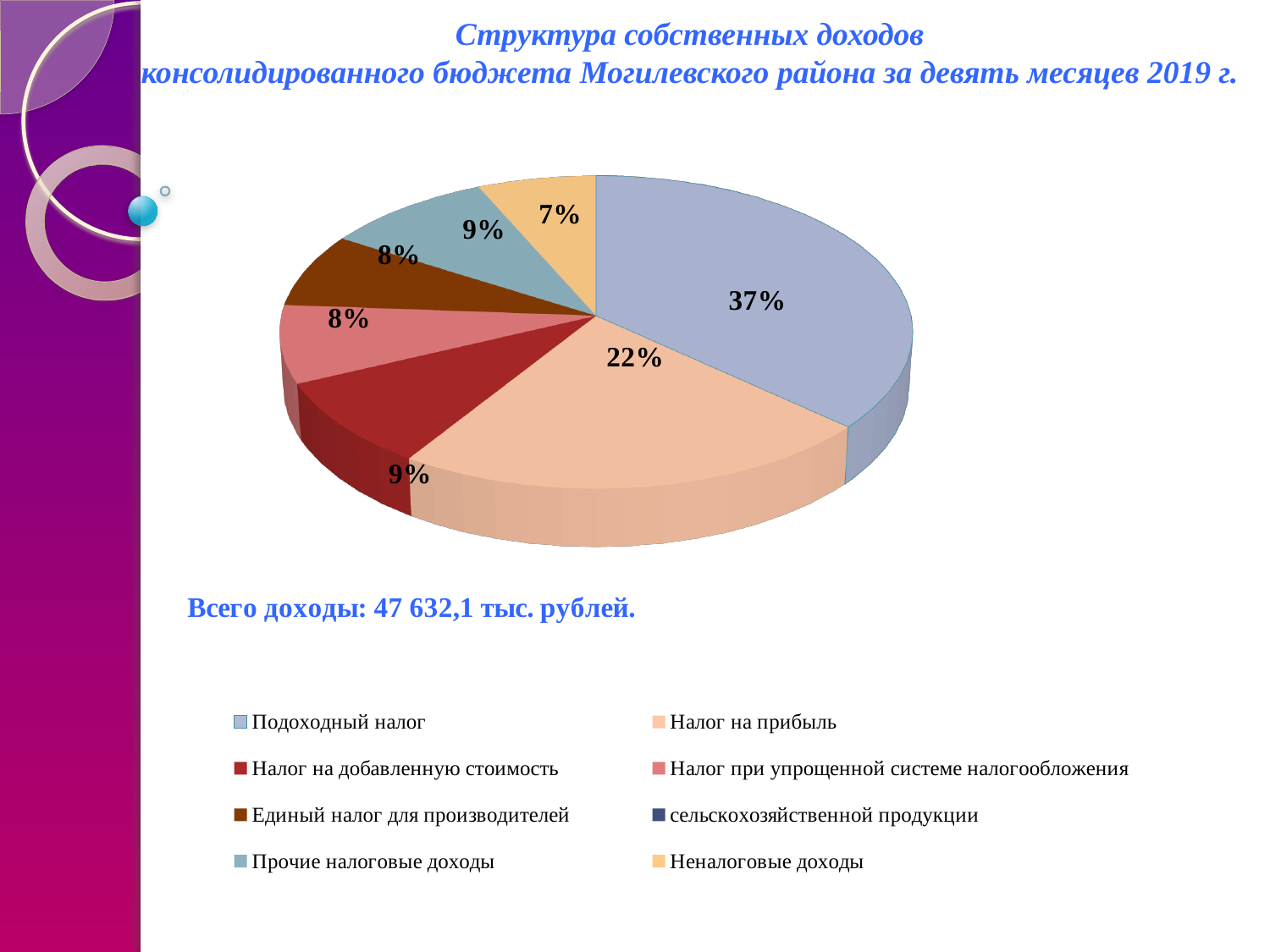
What share of the pie does Неналоговые доходы have? 7% Which is larger, the slice for Налог на прибыль or the slice for Налог на добавленную стоимость? Налог на прибыль What is the difference in percentage points between Подоходный налог and Налог на прибыль? 15 What type of chart is shown on the slide? pie chart What share of the pie does Прочие налоговые доходы have? 9% What total income amount is stated below the chart? 47 632,1 тыс. рублей What share of the pie does Подоходный налог have? 37% Which category has the smallest slice of the pie? Неналоговые доходы Which category has the largest slice of the pie? Подоходный налог How many slices are shown in the pie chart? 7